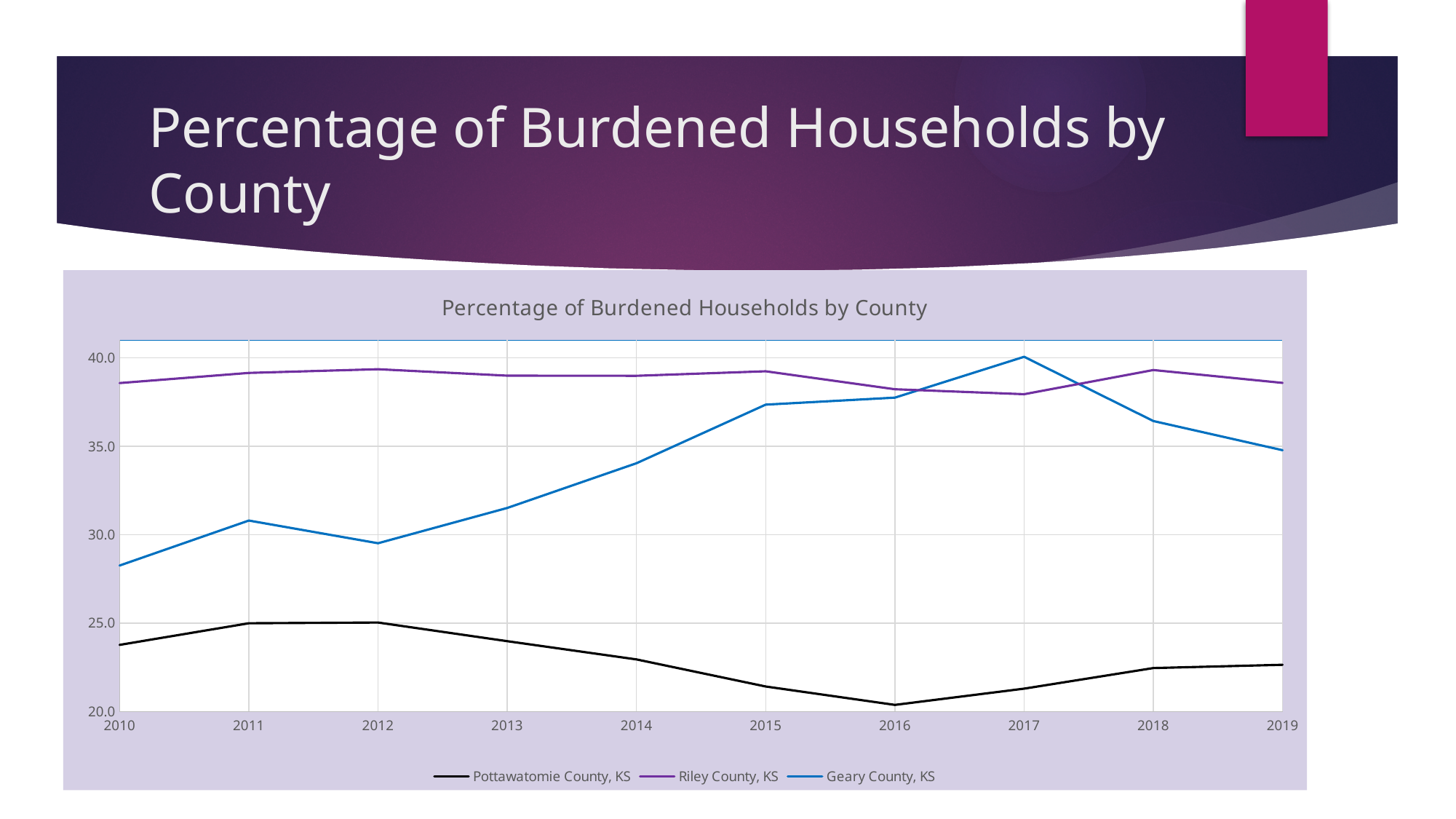
In which year does Geary County, KS reach its highest value? 2017 How many series does the legend list? 3 Does the Geary County, KS line rise or fall from 2012 to 2017? rise Is the value for Geary County, KS in 2010 greater or less than 30.0? less In 2010, which is larger: the value for Riley County, KS or Geary County, KS? Riley County, KS How many years are plotted along the x axis? 10 What kind of chart is shown on the slide? line chart Does the Pottawatomie County, KS line rise or fall from 2012 to 2016? fall Is the value for Pottawatomie County, KS in 2016 greater or less than 25.0? less Which county has the lowest value in 2019? Pottawatomie County, KS In 2017, which is larger: the value for Geary County, KS or Riley County, KS? Geary County, KS Is the value for Geary County, KS in 2017 greater or less than 35.0? greater